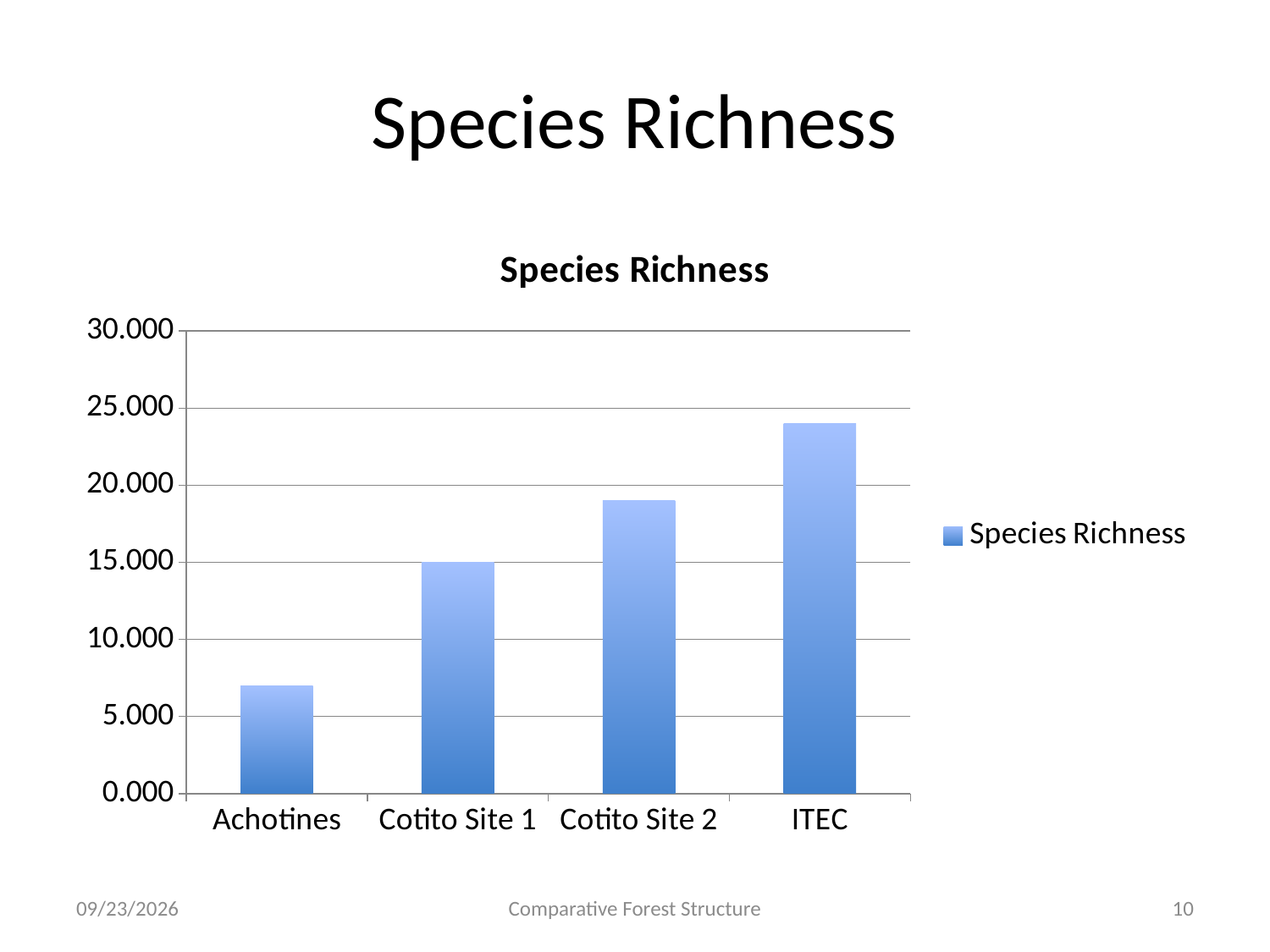
What is the species richness value for Cotito Site 1? 15.000 Do the values rise or fall moving from left to right along the x axis? rise Which has a larger species richness, Cotito Site 2 or Cotito Site 1? Cotito Site 2 What type of chart is shown on the slide? bar chart Is the value for Achotines greater or less than 10.000? less Is the value for ITEC greater or less than 20.000? greater Is the value for Cotito Site 2 greater or less than 20.000? less Which site has the highest species richness? ITEC How many sites are shown on the x axis of the chart? 4 What is the title of the chart? Species Richness How many series does the legend list? 1 Which site has the lowest species richness? Achotines